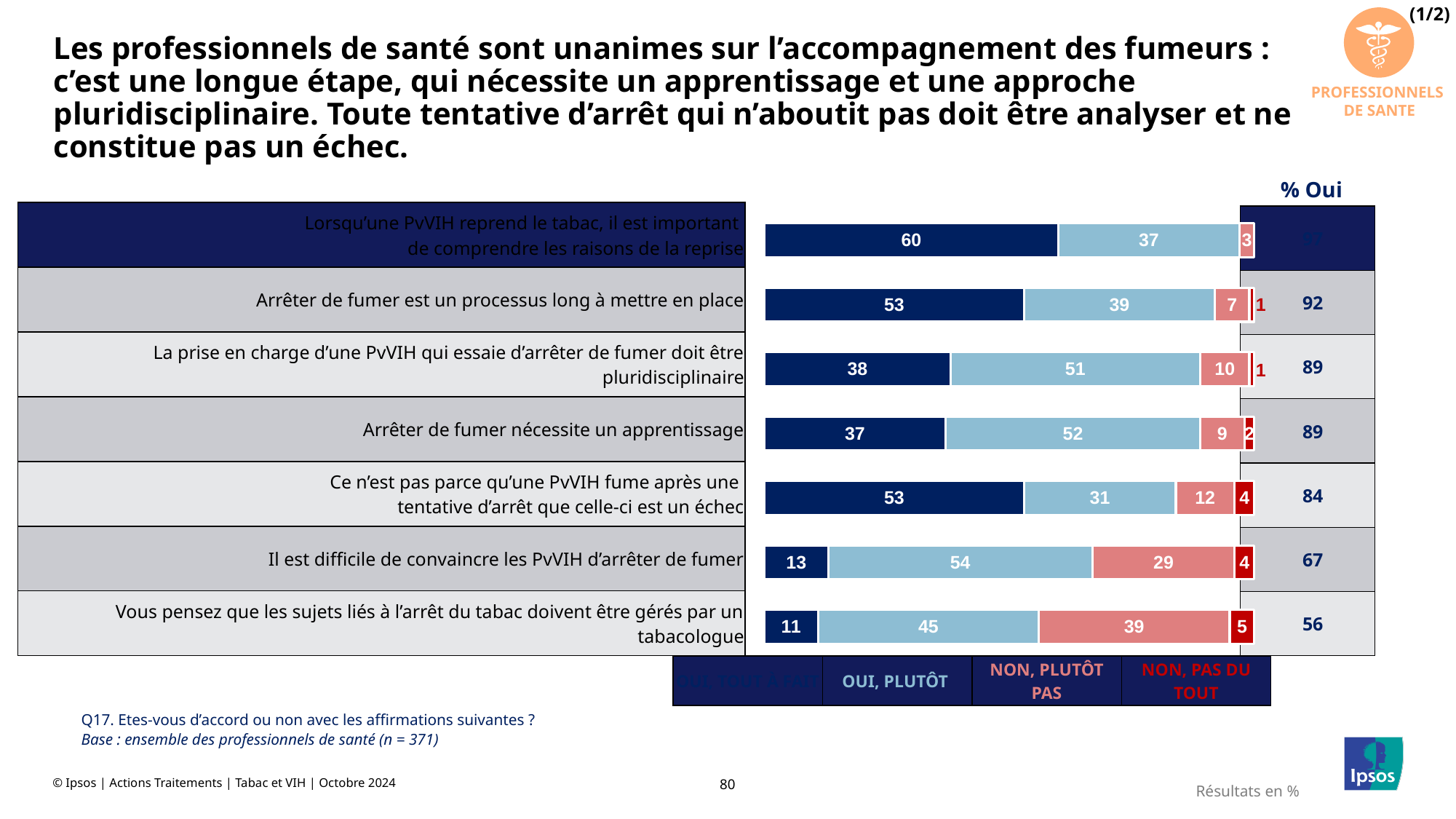
What is the 'Non, pas du tout' value for the statement 'Vous pensez que les sujets liés à l'arrêt du tabac doivent être gérés par un tabacologue'? 5 Which statement has the lowest '% Oui' value? Vous pensez que les sujets liés à l'arrêt du tabac doivent être gérés par un tabacologue What kind of chart is shown on the slide? Stacked bar chart What is the difference in '% Oui' between 'Arrêter de fumer est un processus long à mettre en place' and 'Il est difficile de convaincre les PvVIH d'arrêter de fumer'? 25 Which statement has the largest dark blue (first) segment? Lorsqu'une PvVIH reprend le tabac, il est important de comprendre les raisons de la reprise What is the total of the four segments for the statement 'Ce n'est pas parce qu'une PvVIH fume après une tentative d'arrêt que celle-ci est un échec'? 100 What is the '% Oui' value for the statement 'Il est difficile de convaincre les PvVIH d'arrêter de fumer'? 67 How many series does the legend list? 4 What is the base (n) indicated below the chart? n = 371 Which statement has the larger 'Non, plutôt pas' value: 'Il est difficile de convaincre les PvVIH d'arrêter de fumer' or 'Vous pensez que les sujets liés à l'arrêt du tabac doivent être gérés par un tabacologue'? Vous pensez que les sujets liés à l'arrêt du tabac doivent être gérés par un tabacologue What is the 'Oui, plutôt' value for the statement 'Arrêter de fumer est un processus long à mettre en place'? 39 How many statements are shown in the chart? 7